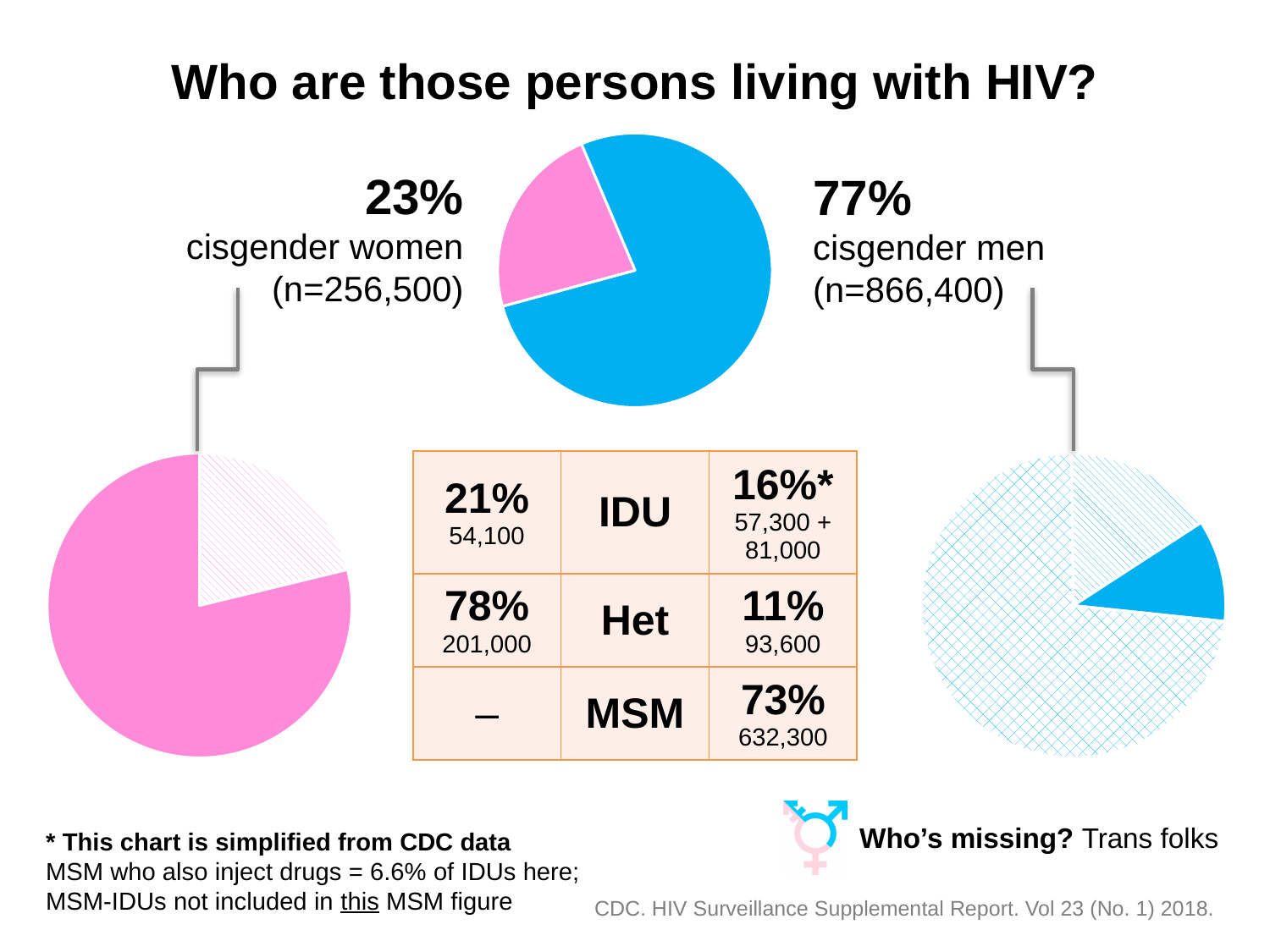
In the bottom-right pie chart for cisgender men, which category has the smallest share? Het In the bottom-right pie chart for cisgender men, what is the number of Het cases? 93,600 In the top pie chart, what is the number of cisgender men living with HIV (n)? 866,400 What type of chart is used on this slide to show the breakdown of persons living with HIV? pie chart In the top pie chart, which group has the larger share: cisgender women or cisgender men? cisgender men In the top pie chart, what percentage of persons living with HIV are cisgender men? 77% In the bottom-right pie chart for cisgender men, what percentage is MSM? 73% In the top pie chart, what percentage of persons living with HIV are cisgender women? 23% In the top pie chart, what is the number of cisgender women living with HIV (n)? 256,500 In the bottom-left pie chart for cisgender women, what is the number of IDU cases? 54,100 In the bottom-left pie chart for cisgender women, what percentage is Het (heterosexual contact)? 78% In the top pie chart, what is the difference in percentage points between the cisgender men and cisgender women shares? 54